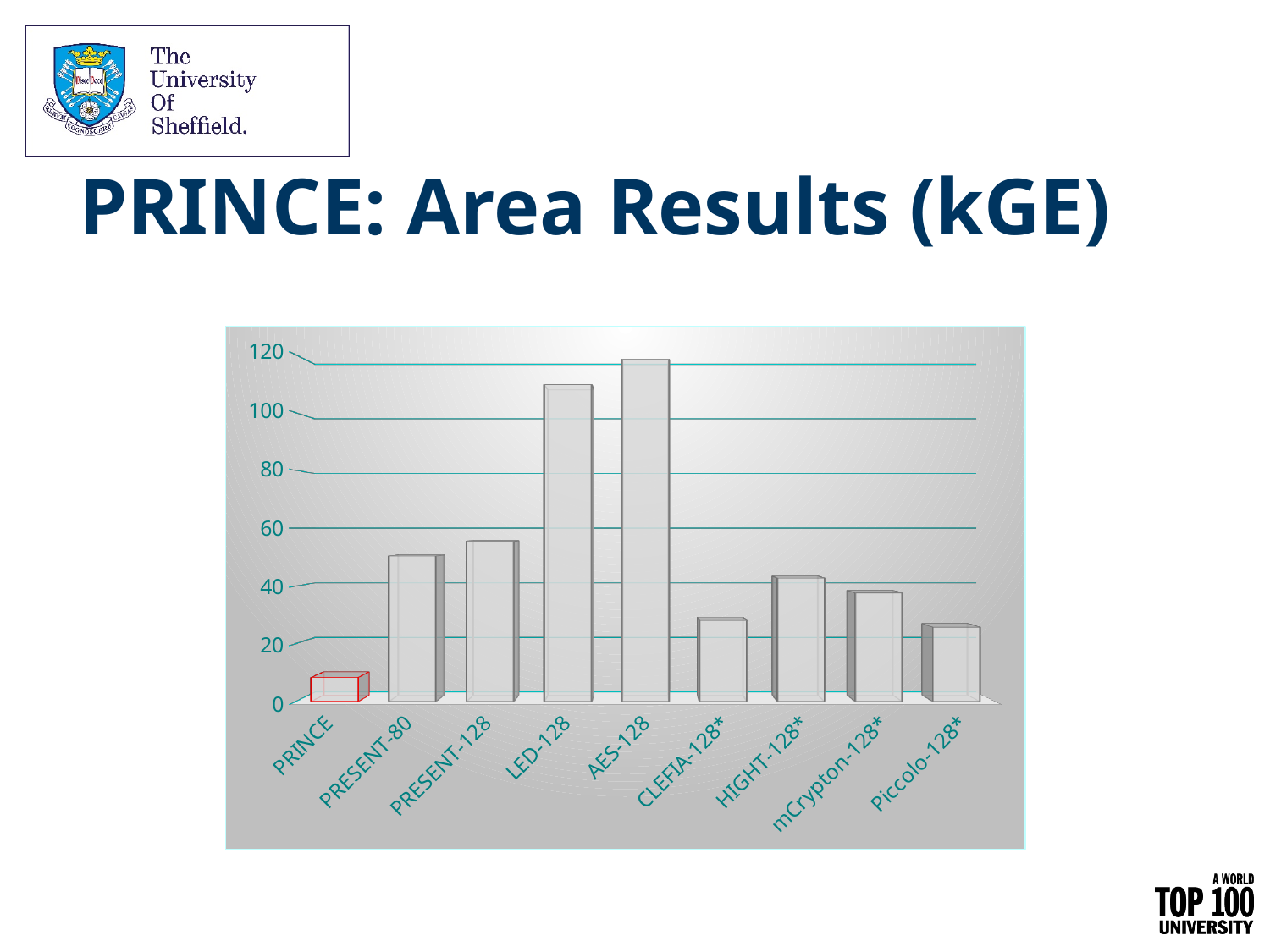
What kind of chart is shown on the slide? bar chart Which has the larger value, LED-128 or PRESENT-80? LED-128 Which category has the highest bar in the chart? AES-128 Which category has the lowest bar in the chart? PRINCE How many categories (ciphers) are shown on the x axis of the chart? 9 Is the value for Piccolo-128* greater or less than 40? less Which has the larger value, HIGHT-128* or CLEFIA-128*? HIGHT-128* Is the value for PRESENT-128 greater or less than 40? greater Is the value for LED-128 greater or less than 100? greater Which bar in the chart is outlined in red? PRINCE